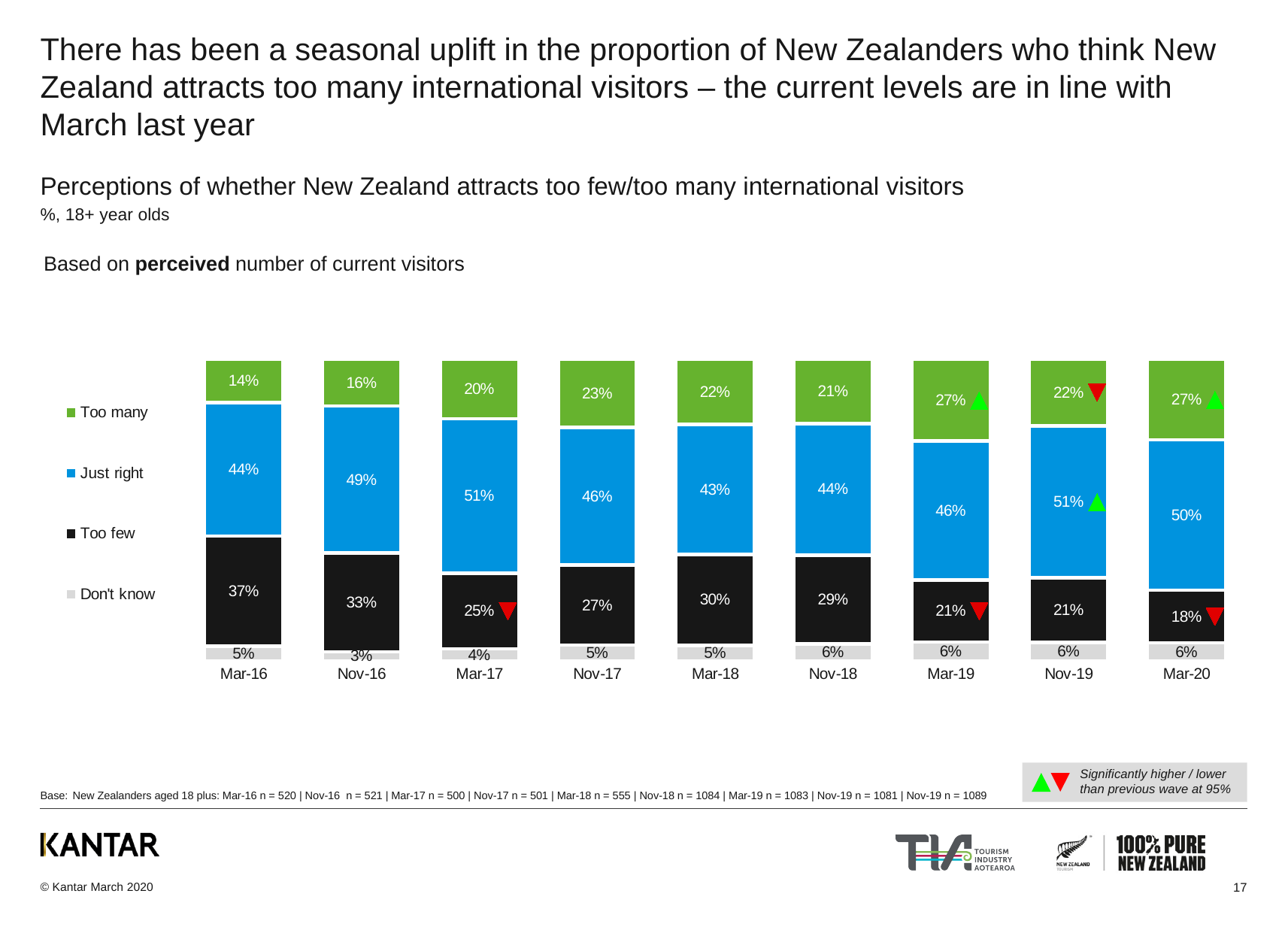
What is the "Don't know" value for Nov-16? 3% In which wave is the "Too few" value highest? Mar-16 Which wave has the larger "Just right" value, Nov-16 or Mar-18? Nov-16 In which wave is the "Too few" value lowest? Mar-20 By how many percentage points did the "Too few" value fall from Mar-16 to Mar-20? 19 percentage points How many survey waves are shown on the x axis? 9 What kind of chart is shown on the slide? Stacked bar chart In which wave is the "Too many" value lowest? Mar-16 What is the "Just right" value for Nov-16? 49% How many series does the legend list? 4 What percentage of respondents said "Too many" in Mar-20? 27% Does the "Too few" value generally rise or fall from Mar-16 to Mar-20? Fall